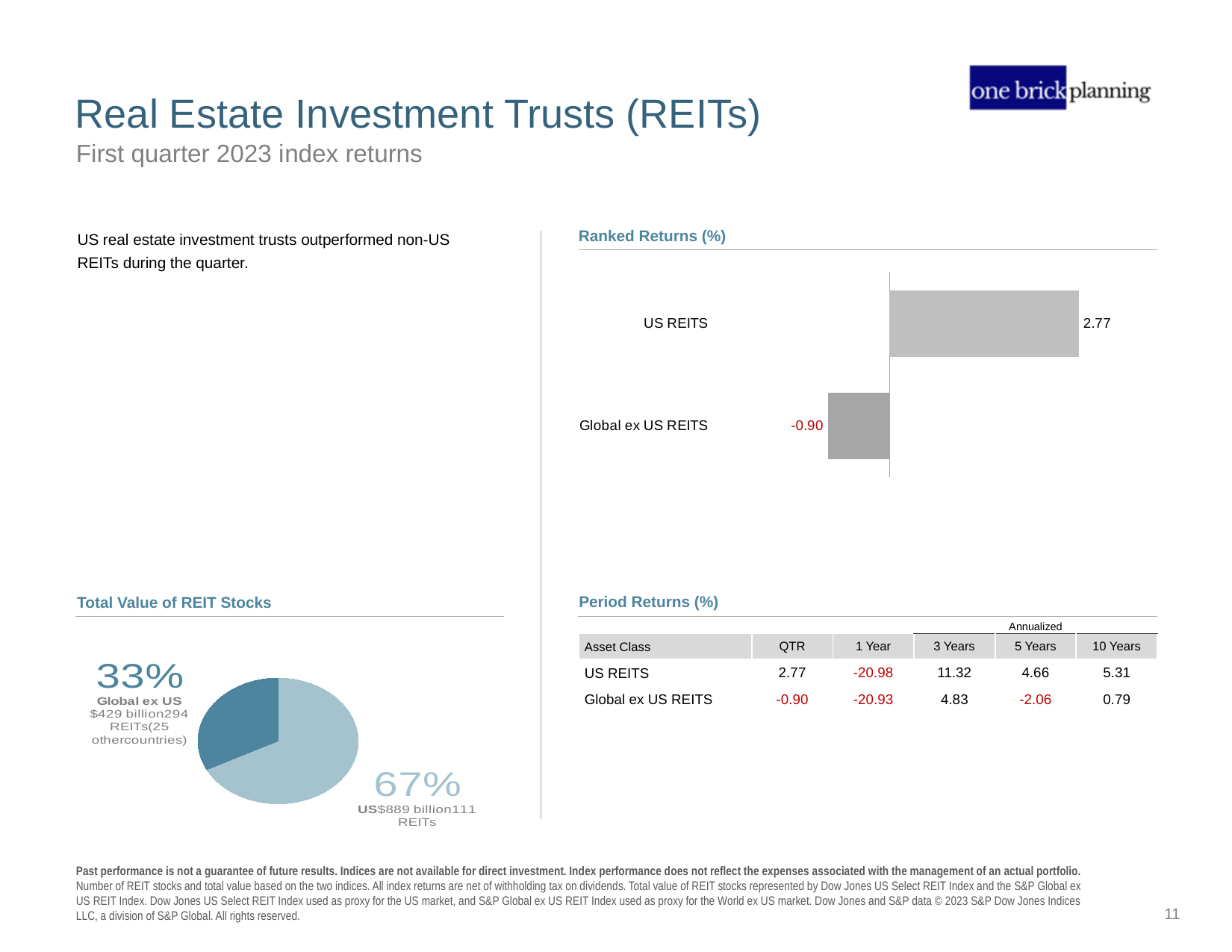
In the Total Value of REIT Stocks chart, which slice is larger, US or Global ex US? US What kind of chart is the Total Value of REIT Stocks chart? Pie chart In the Ranked Returns (%) chart, what is the value for US REITS? 2.77 In the Total Value of REIT Stocks chart, what share of the pie is US? 67% In the Ranked Returns (%) chart, how many categories are plotted? 2 In the Total Value of REIT Stocks chart, what share of the pie is Global ex US? 33% In the Ranked Returns (%) chart, is the value for Global ex US REITS positive or negative? Negative In the Ranked Returns (%) chart, what is the difference between the US REITS value and the Global ex US REITS value? 3.67 What kind of chart is the Ranked Returns (%) chart? Bar chart In the Ranked Returns (%) chart, which category has the lowest value? Global ex US REITS In the Ranked Returns (%) chart, what is the value for Global ex US REITS? -0.90 In the Ranked Returns (%) chart, which category has the highest value? US REITS